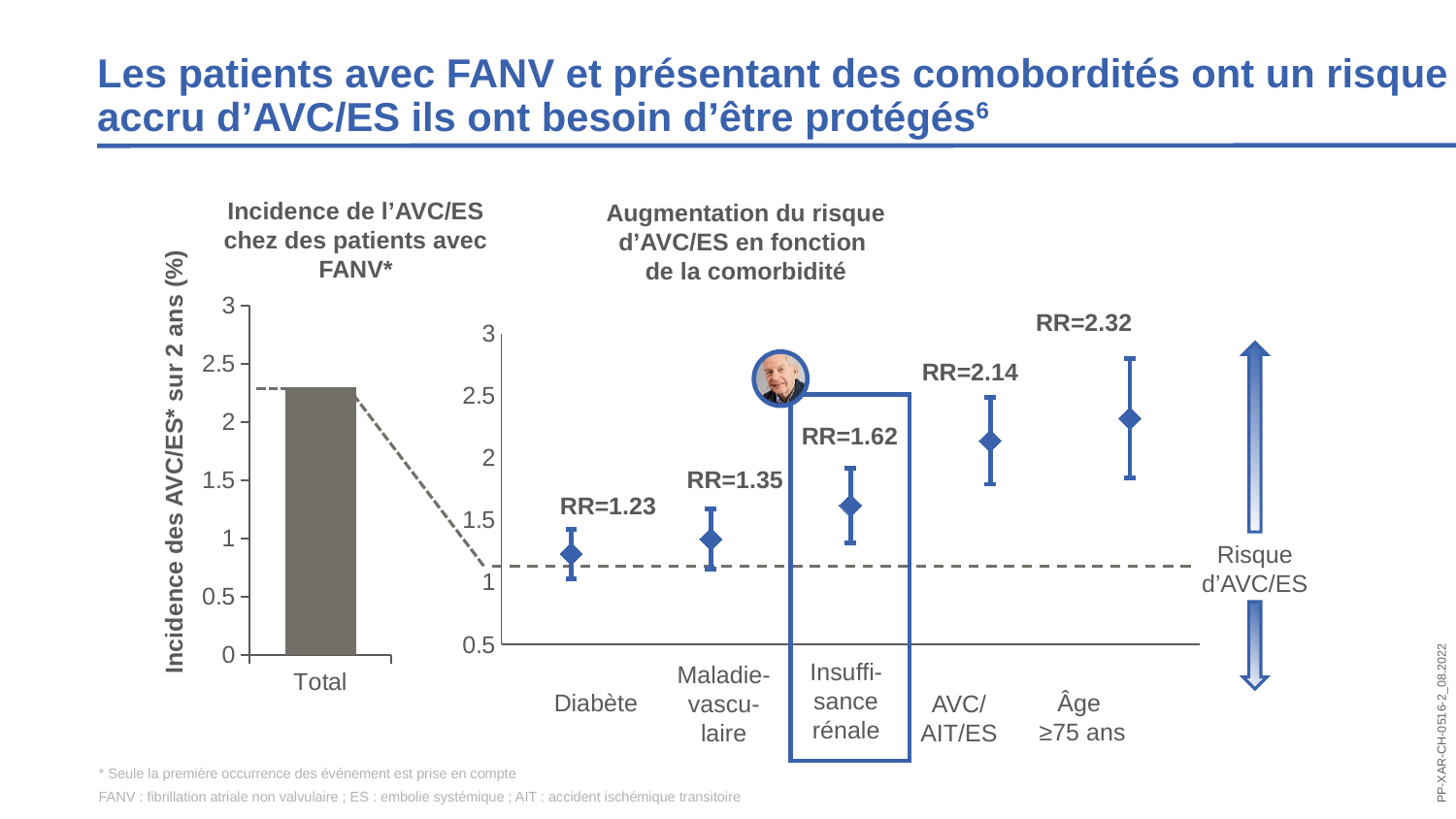
In the chart 'Augmentation du risque d'AVC/ES en fonction de la comorbidité', do the RR values rise or fall from left to right along the x axis? rise In the chart 'Augmentation du risque d'AVC/ES en fonction de la comorbidité', what is the difference between the RR for Âge ≥75 ans and the RR for Diabète? 1.09 In the chart 'Augmentation du risque d'AVC/ES en fonction de la comorbidité', what is the RR value for Diabète? RR=1.23 In the chart 'Augmentation du risque d'AVC/ES en fonction de la comorbidité', how many comorbidity categories are plotted? 5 In the chart 'Augmentation du risque d'AVC/ES en fonction de la comorbidité', what is the RR value for Insuffisance rénale? RR=1.62 In the chart 'Augmentation du risque d'AVC/ES en fonction de la comorbidité', which comorbidity has the highest RR? Âge ≥75 ans In the chart 'Augmentation du risque d'AVC/ES en fonction de la comorbidité', what is the RR value for AVC/AIT/ES? RR=2.14 In the chart 'Augmentation du risque d'AVC/ES en fonction de la comorbidité', which has a larger RR: Maladie vasculaire or AVC/AIT/ES? AVC/AIT/ES In the chart 'Augmentation du risque d'AVC/ES en fonction de la comorbidité', which comorbidity has the lowest RR? Diabète In the chart 'Augmentation du risque d'AVC/ES en fonction de la comorbidité', what is the difference between the RR for Insuffisance rénale and the RR for Maladie vasculaire? 0.27 What kind of chart is the left chart 'Incidence de l'AVC/ES chez des patients avec FANV*'? bar chart In the chart 'Incidence de l'AVC/ES chez des patients avec FANV*', is the value for Total greater or less than 2? greater